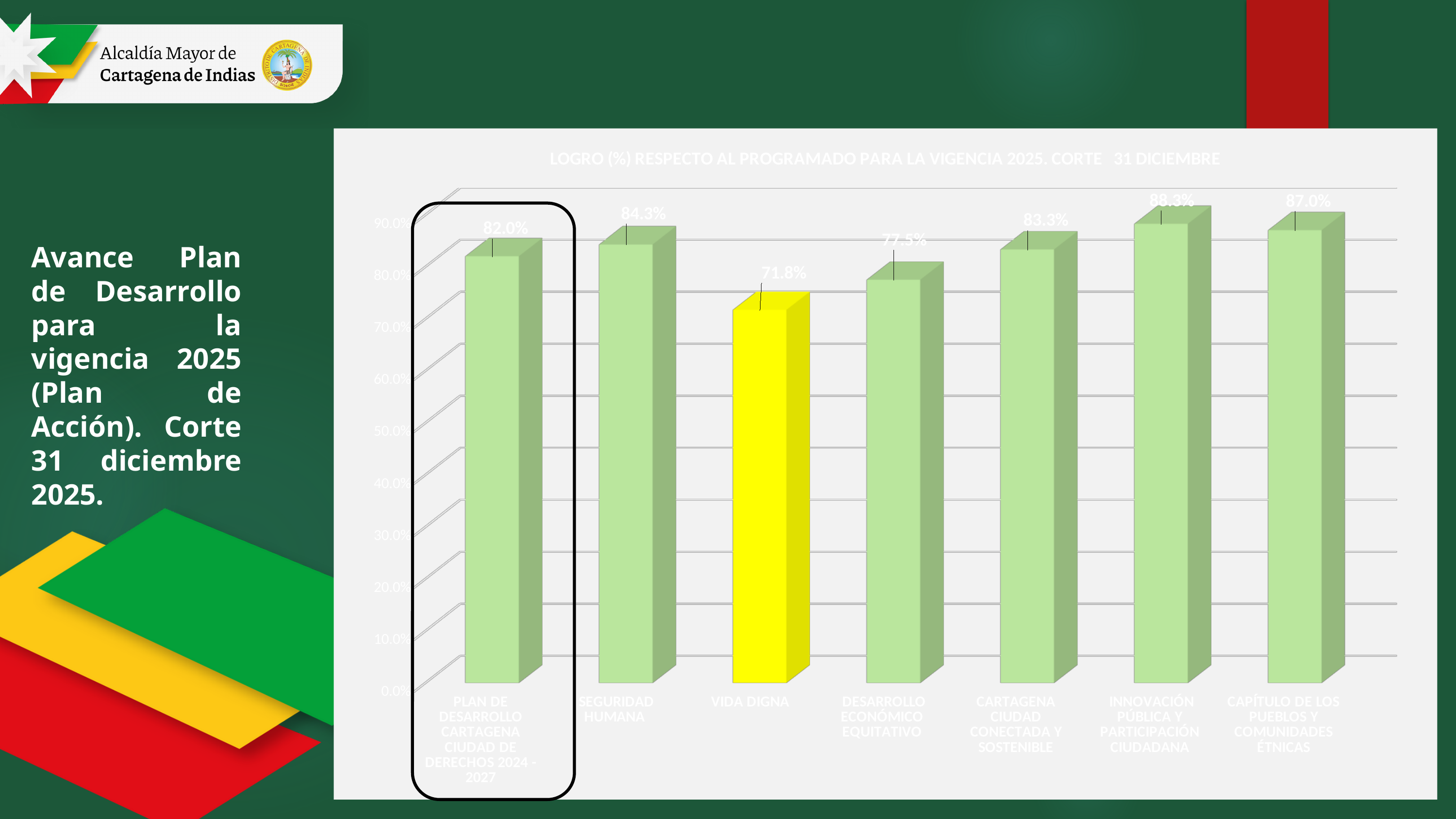
Which category has the lowest value? VIDA DIGNA Which is larger, the value for CARTAGENA CIUDAD CONECTADA Y SOSTENIBLE or the value for SEGURIDAD HUMANA? SEGURIDAD HUMANA What is the value for VIDA DIGNA? 71.8% Which category has the highest value? INNOVACIÓN PÚBLICA Y PARTICIPACIÓN CIUDADANA Is the value for DESARROLLO ECONÓMICO EQUITATIVO greater or less than 80.0%? less How many categories are shown in the chart? 7 What kind of chart is shown on the slide? bar chart What is the value for INNOVACIÓN PÚBLICA Y PARTICIPACIÓN CIUDADANA? 88.3% Which bar is coloured yellow instead of green? VIDA DIGNA What is the value for PLAN DE DESARROLLO CARTAGENA CIUDAD DE DERECHOS 2024 - 2027? 82.0% What is the difference between the values for CAPÍTULO DE LOS PUEBLOS Y COMUNIDADES ÉTNICAS and DESARROLLO ECONÓMICO EQUITATIVO? 9.5% What is the value for SEGURIDAD HUMANA? 84.3%